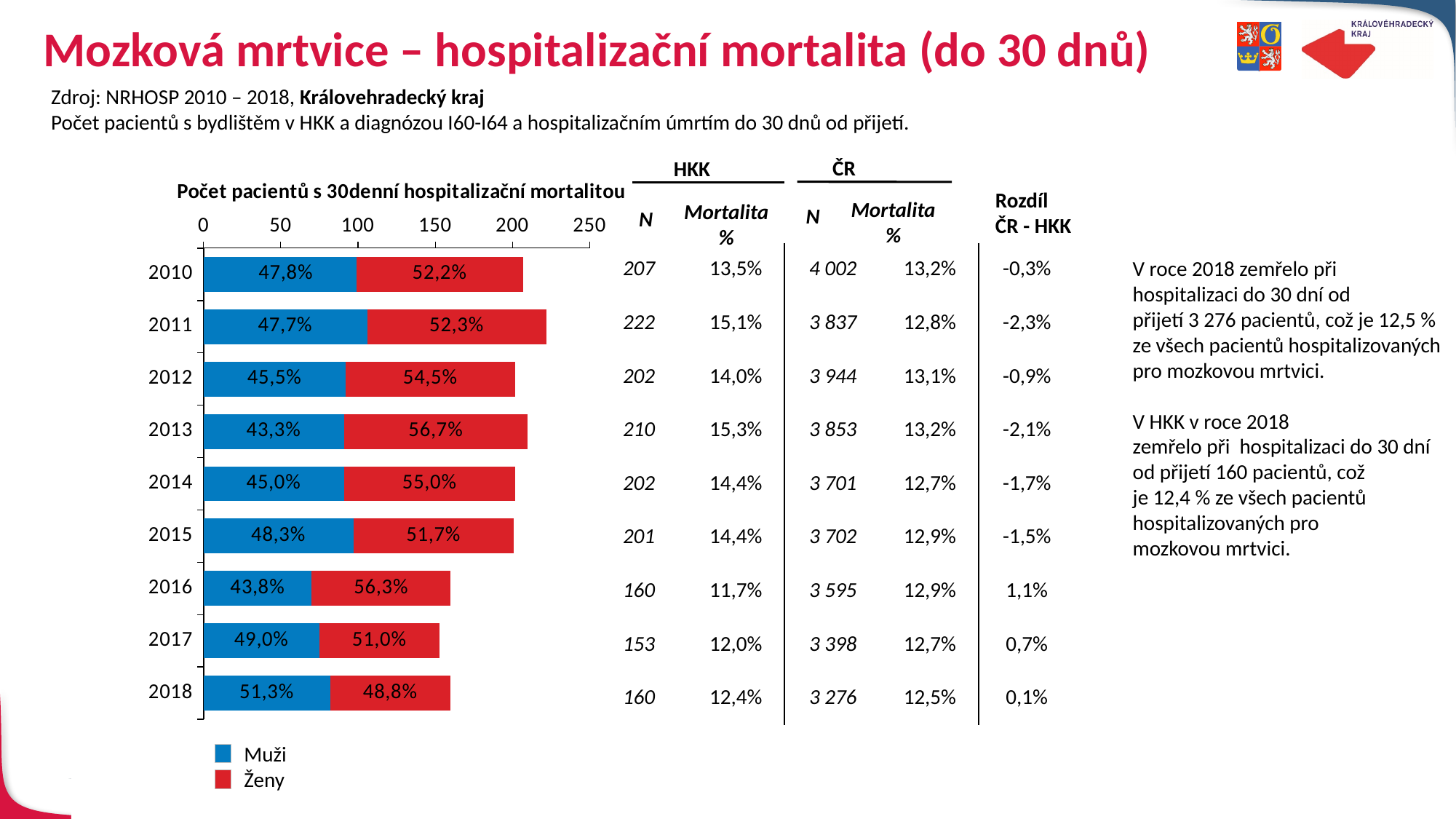
What kind of chart is shown on the slide? Stacked bar chart Which colour represents Muži in the chart? Blue Is the total length of the 2011 bar greater or less than 200? greater How many years are shown on the bar chart? 9 Is the total length of the 2016 bar greater or less than 200? less By how many percentage points does the Muži share exceed the Ženy share in 2018? 2,5% What percentage of the 2013 bar is Ženy? 56,7% What percentage of the 2010 bar is Muži? 47,8% In which year is the Muži share the highest? 2018 Which year has the larger Ženy share, 2016 or 2017? 2016 How many series does the legend list? 2 In which year is the Muži share the lowest? 2013